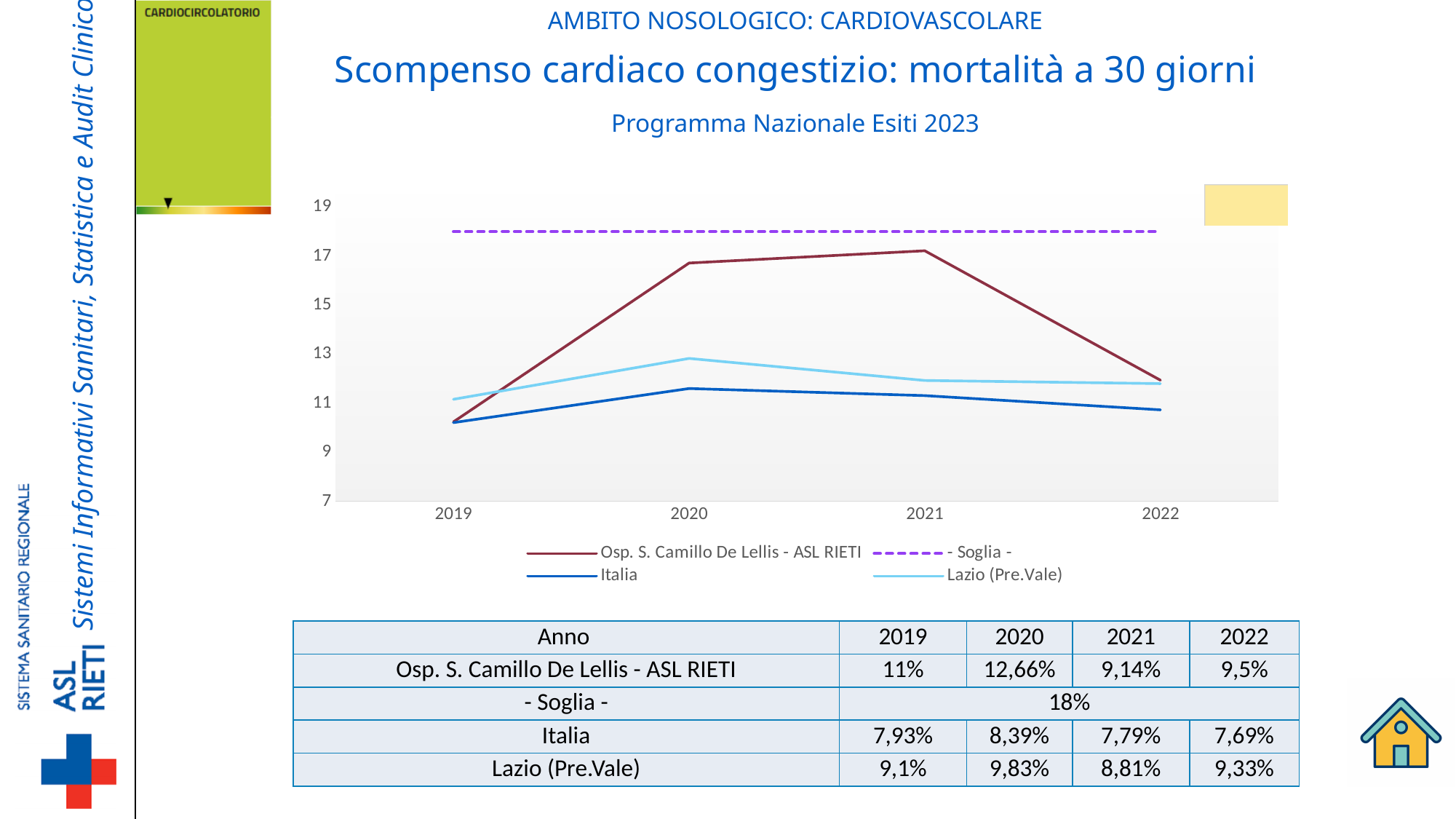
What kind of chart is shown on the slide? line chart In which year does the Osp. S. Camillo De Lellis - ASL RIETI line reach its lowest point? 2019 Does the Osp. S. Camillo De Lellis - ASL RIETI line rise or fall from 2021 to 2022? fall In which year does the Lazio (Pre.Vale) line reach its highest point? 2020 In 2020, which is larger: the value for Osp. S. Camillo De Lellis - ASL RIETI or the value for Italia? Osp. S. Camillo De Lellis - ASL RIETI Is the value for Italia in 2022 greater or less than 11? less How many series does the chart legend list? 4 In 2019, which is larger: the value for Lazio (Pre.Vale) or the value for Osp. S. Camillo De Lellis - ASL RIETI? Lazio (Pre.Vale) What is the subtitle shown under the main title of the slide? Programma Nazionale Esiti 2023 How many years are shown on the x axis of the chart? 4 Which series is drawn as a dashed line in the chart? - Soglia - Is the value for Osp. S. Camillo De Lellis - ASL RIETI in 2020 greater or less than 15? greater